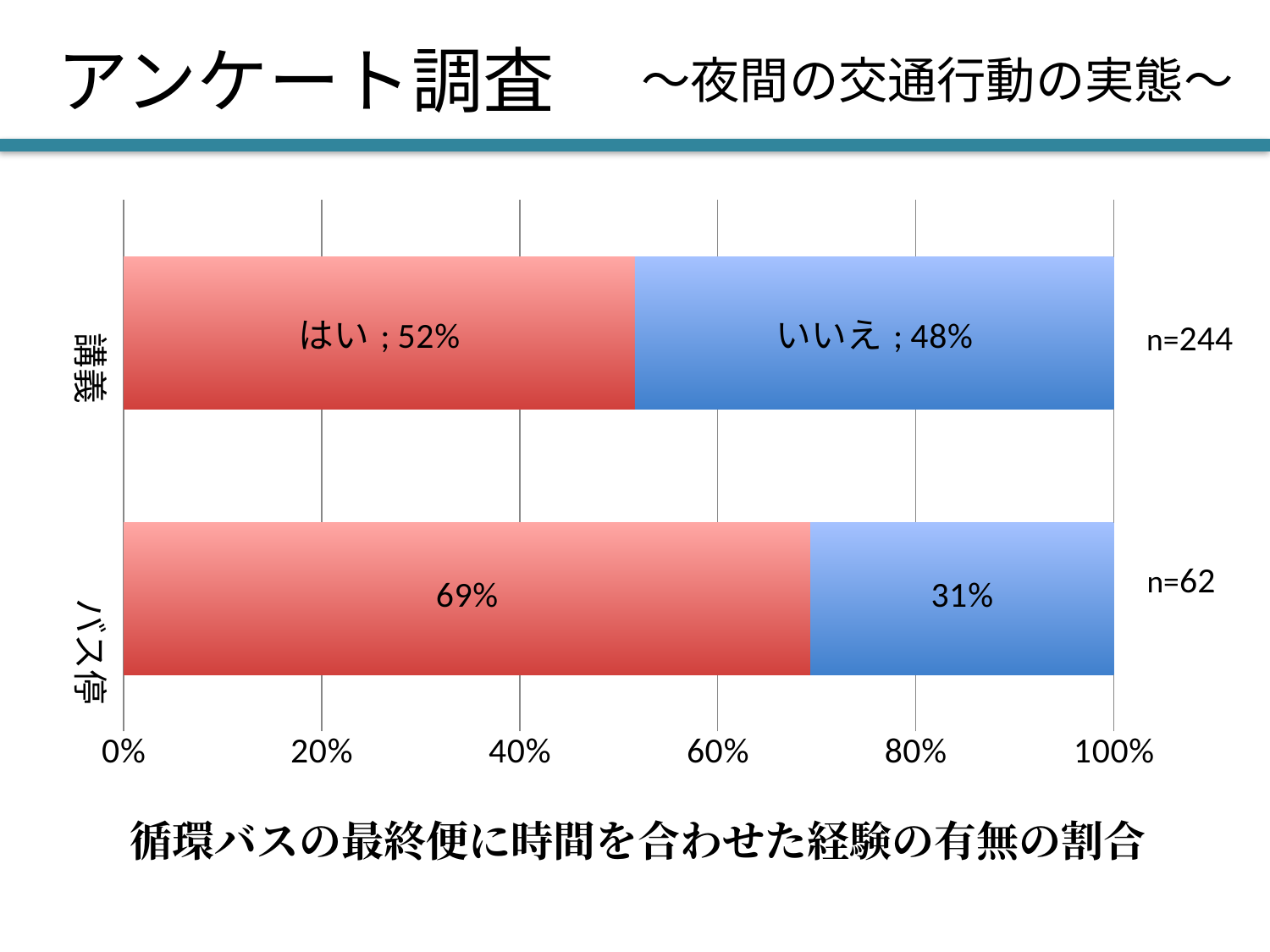
What percentage of 講義 respondents answered はい? 52% What percentage of バス停 respondents answered はい (red segment)? 69% What type of chart is shown on the slide? Stacked bar chart What is the difference between the はい share for バス停 and the はい share for 講義? 17% How many categories are shown on the vertical axis? 2 What is the sample size (n) for the バス停 category? n=62 What percentage of 講義 respondents answered いいえ? 48% Which category has the higher はい share, 講義 or バス停? バス停 What is the difference between the はい and いいえ shares for 講義? 4% What percentage of バス停 respondents answered いいえ (blue segment)? 31% What is the sample size (n) for the 講義 category? n=244 What is the total of the two segments in the バス停 bar? 100%